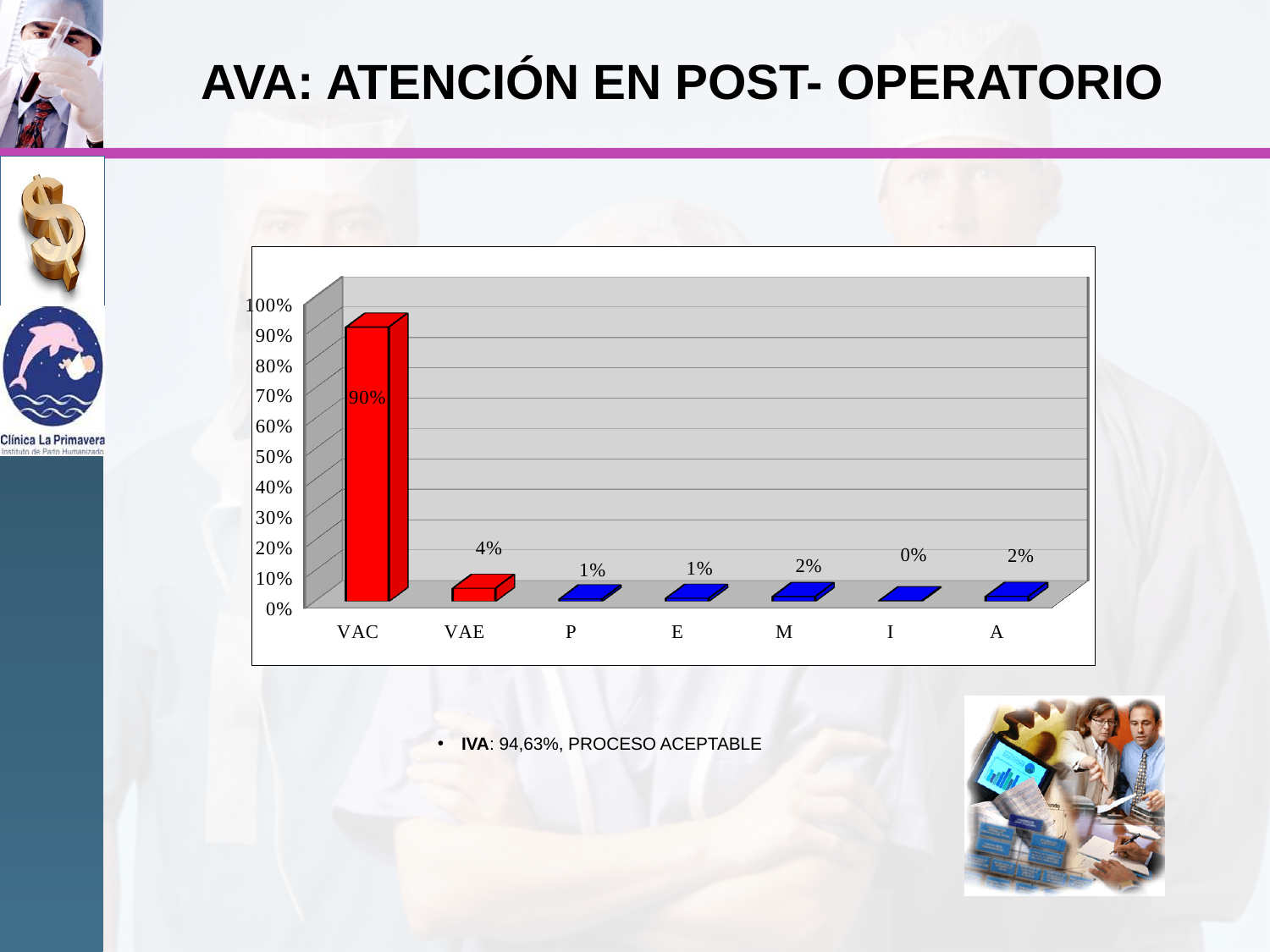
Which is larger, the value for VAE or the value for A? VAE What kind of chart is shown on the slide? Bar chart What is the value for M? 2% Which category has the lowest value? I Which category has the highest value? VAC How many categories are shown on the x axis? 7 What is the value for I? 0% What colour is the bar for VAC? Red What is the value for VAC? 90% What is the value for VAE? 4% What is the difference between the values for VAE and M? 2% What is the difference between the values for VAC and VAE? 86%